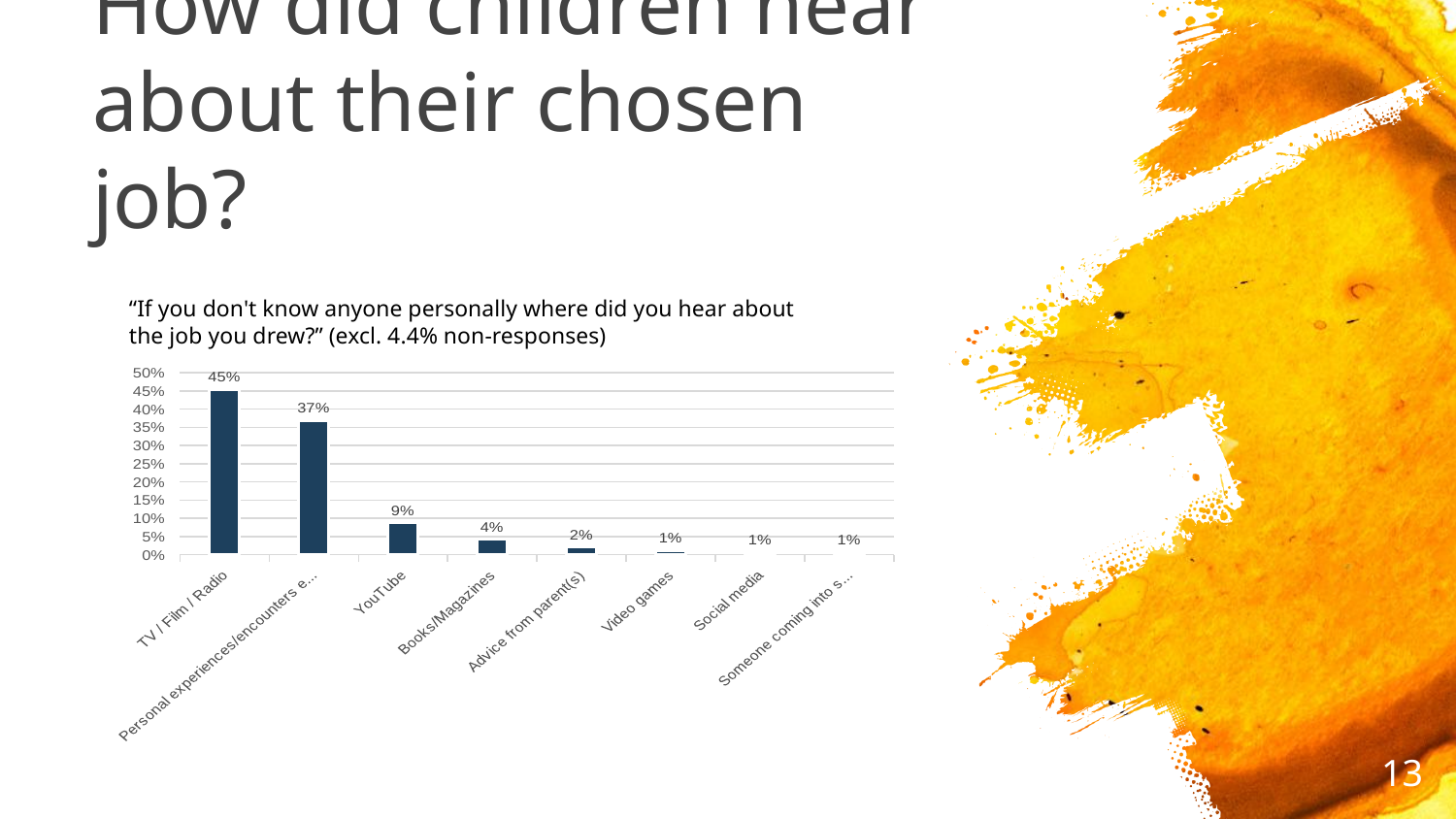
What percentage is shown for Video games? 1% What is the difference between the values for YouTube and Books/Magazines? 5% How many categories are shown on the x axis of the chart? 8 What is the value shown for YouTube? 9% What percentage is shown for Books/Magazines? 4% Do the values rise or fall moving from left to right along the x axis? Fall What is the difference between the values for TV / Film / Radio and YouTube? 36% What is the value for Advice from parent(s)? 2% What kind of chart is shown on the slide? Bar chart What percentage of children heard about their chosen job from TV / Film / Radio? 45% Which is larger, the value for YouTube or the value for Social media? YouTube Which category has the highest value in the chart? TV / Film / Radio